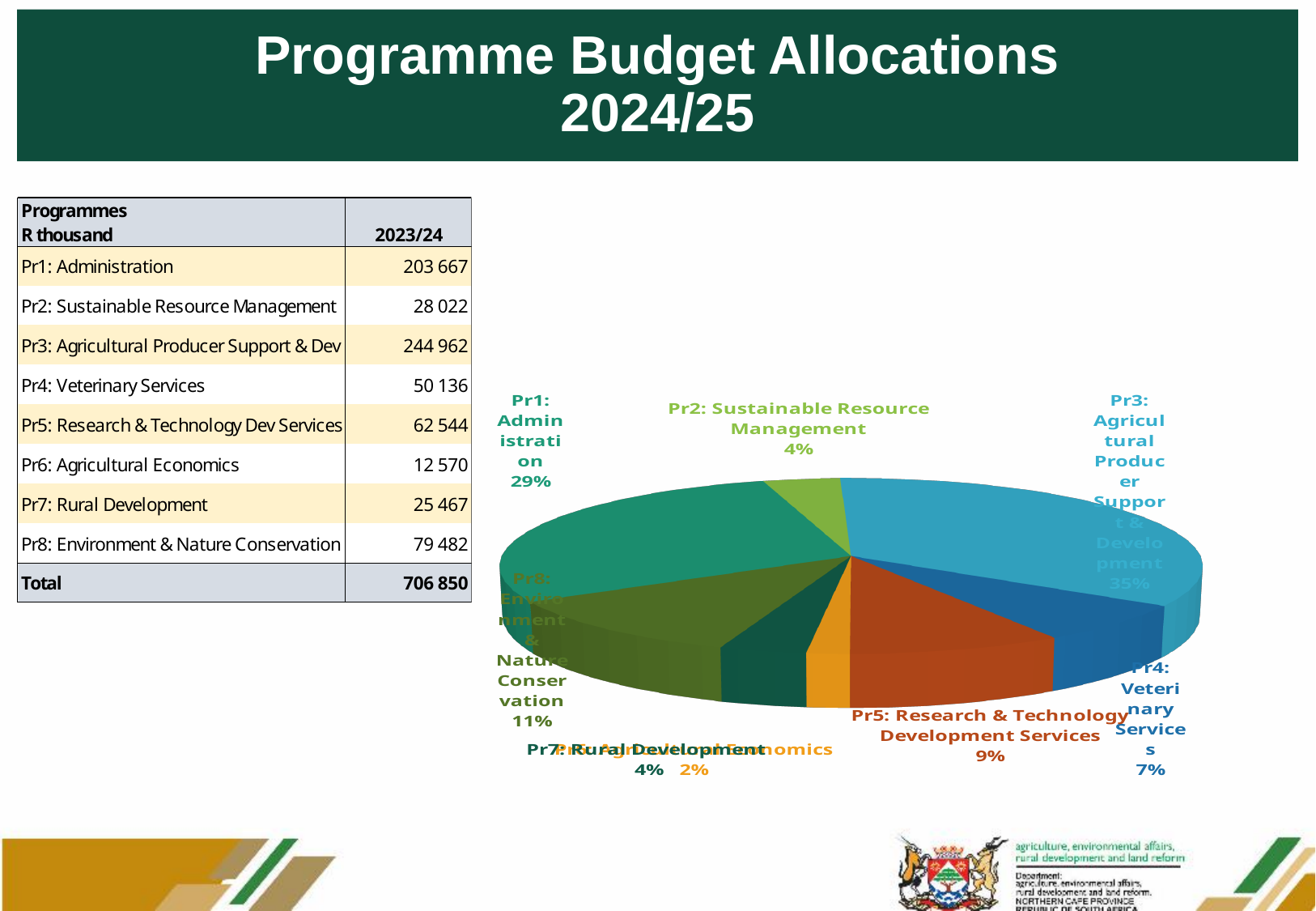
What share of the pie does Pr4: Veterinary Services represent? 7% What share of the pie does Pr1: Administration represent? 29% How many slices does the pie chart have? 8 Which has the larger share, Pr8: Environment & Nature Conservation or Pr5: Research & Technology Development Services? Pr8: Environment & Nature Conservation Which programme has the smallest slice of the pie? Pr6: Agricultural Economics What share of the pie does Pr5: Research & Technology Development Services represent? 9% What is the title of the slide containing the pie chart? Programme Budget Allocations 2024/25 Which programme has the largest slice of the pie? Pr3: Agricultural Producer Support & Development What kind of chart is shown on the slide? pie chart By how many percentage points does the Pr3: Agricultural Producer Support & Development share exceed the Pr1: Administration share? 6